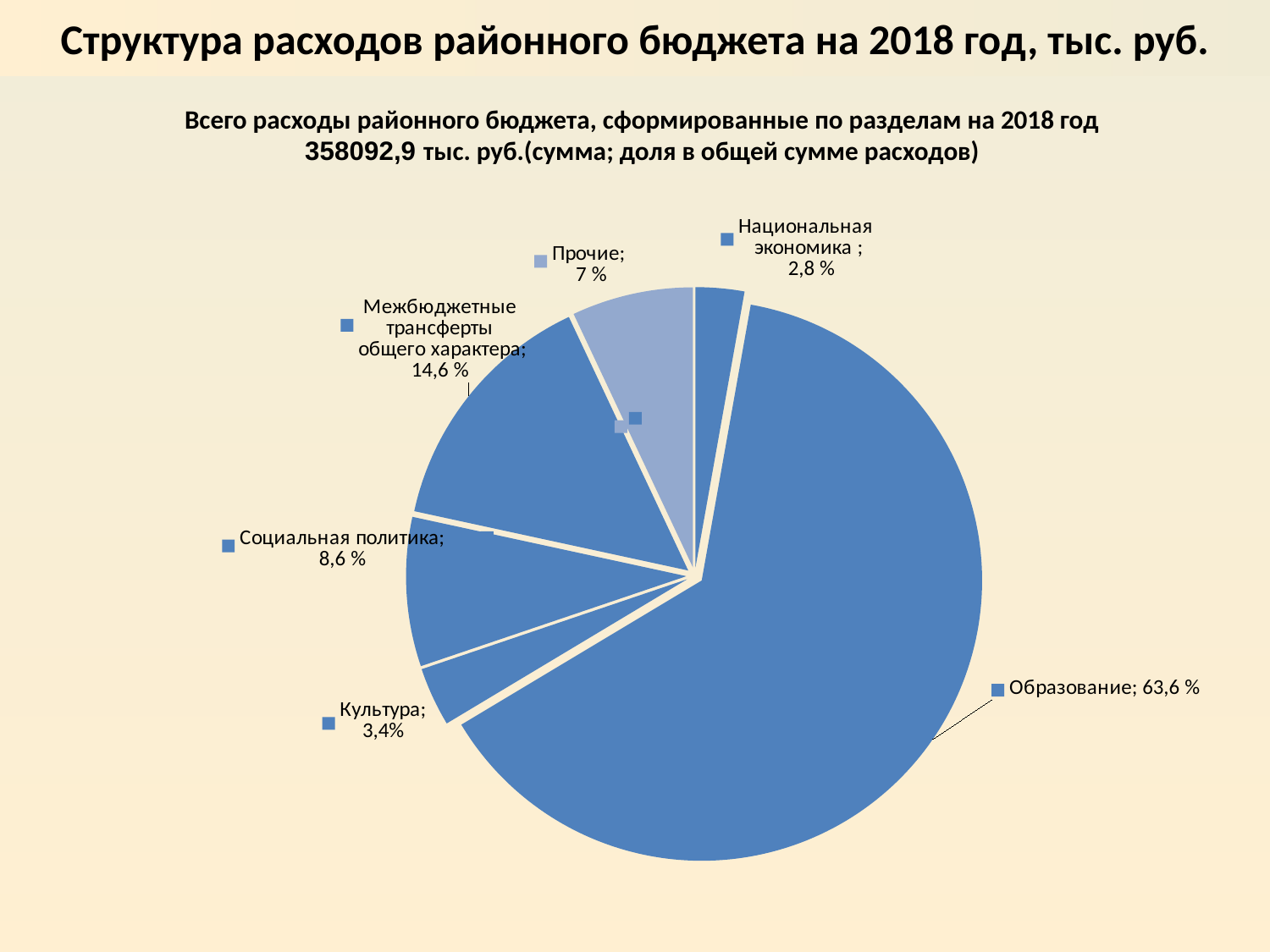
What share is shown for Прочие? 7 % What share is shown for Социальная политика? 8,6 % What type of chart is shown on the slide? pie chart What share is shown for Культура? 3,4% What share is shown for Межбюджетные трансферты общего характера? 14,6 % Which labelled category has the smallest share of the pie? Национальная экономика Which category has the largest share of the pie? Образование By how many percentage points does the share of Образование exceed that of Межбюджетные трансферты общего характера? 49 % Which has a larger share, Социальная политика or Прочие? Социальная политика What share of expenditures is labelled for Образование? 63,6 % According to the chart subtitle, what is the total amount of district budget expenditures for 2018? 358092,9 тыс. руб. What share is shown for Национальная экономика? 2,8 %